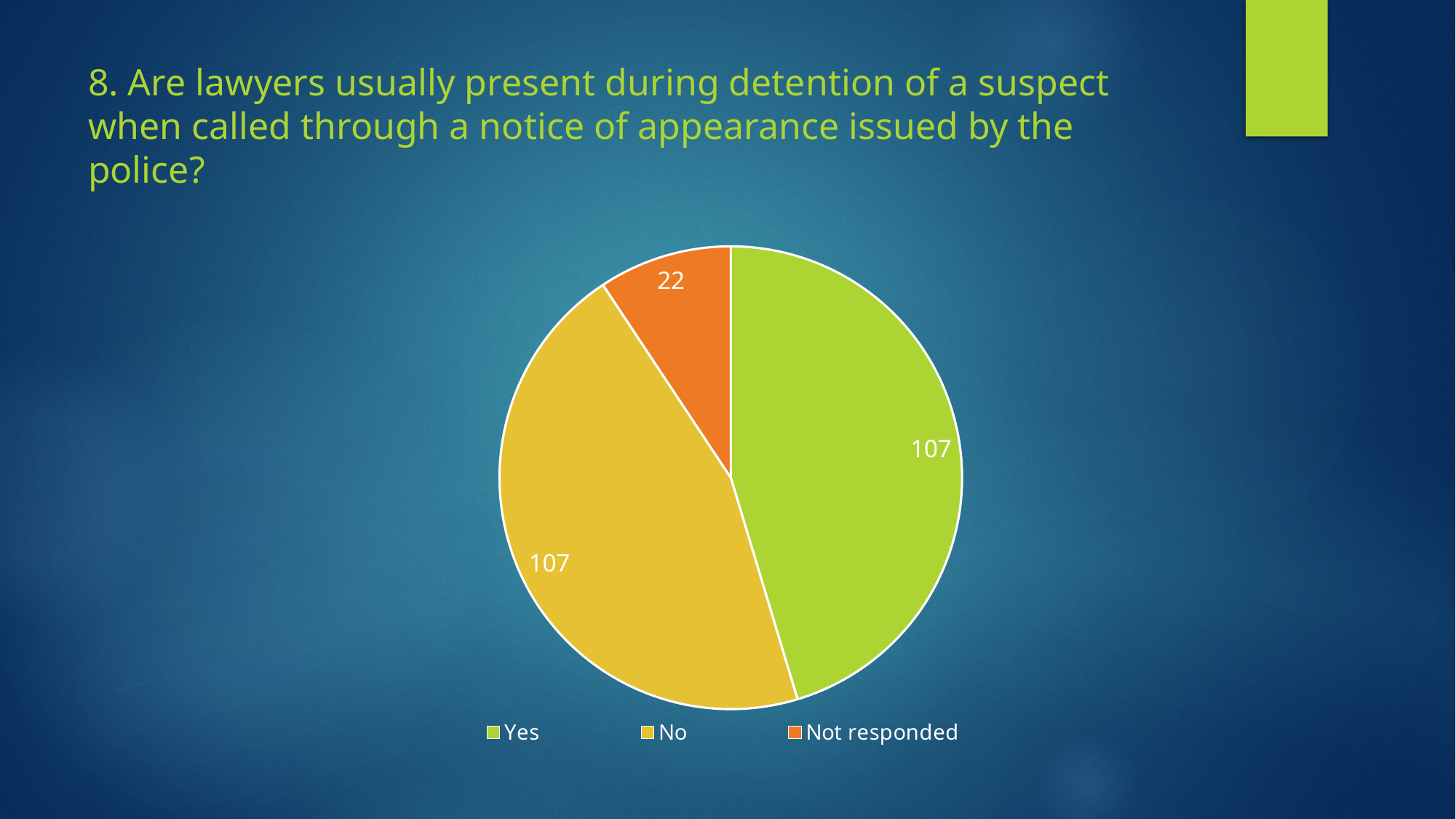
What kind of chart is shown on the slide? Pie chart What value is shown for the No slice? 107 What colour is the Not responded slice? Orange What is the difference between the Yes value and the Not responded value? 85 How many entries does the legend list? 3 What is the difference between the Yes value and the No value? 0 Which category has the smallest slice of the pie? Not responded How many categories does the pie chart show? 3 What value is shown for the Yes slice? 107 What is the total of all the slices in the pie chart? 236 Which is larger, the No slice or the Not responded slice? No What value is shown for the Not responded slice? 22